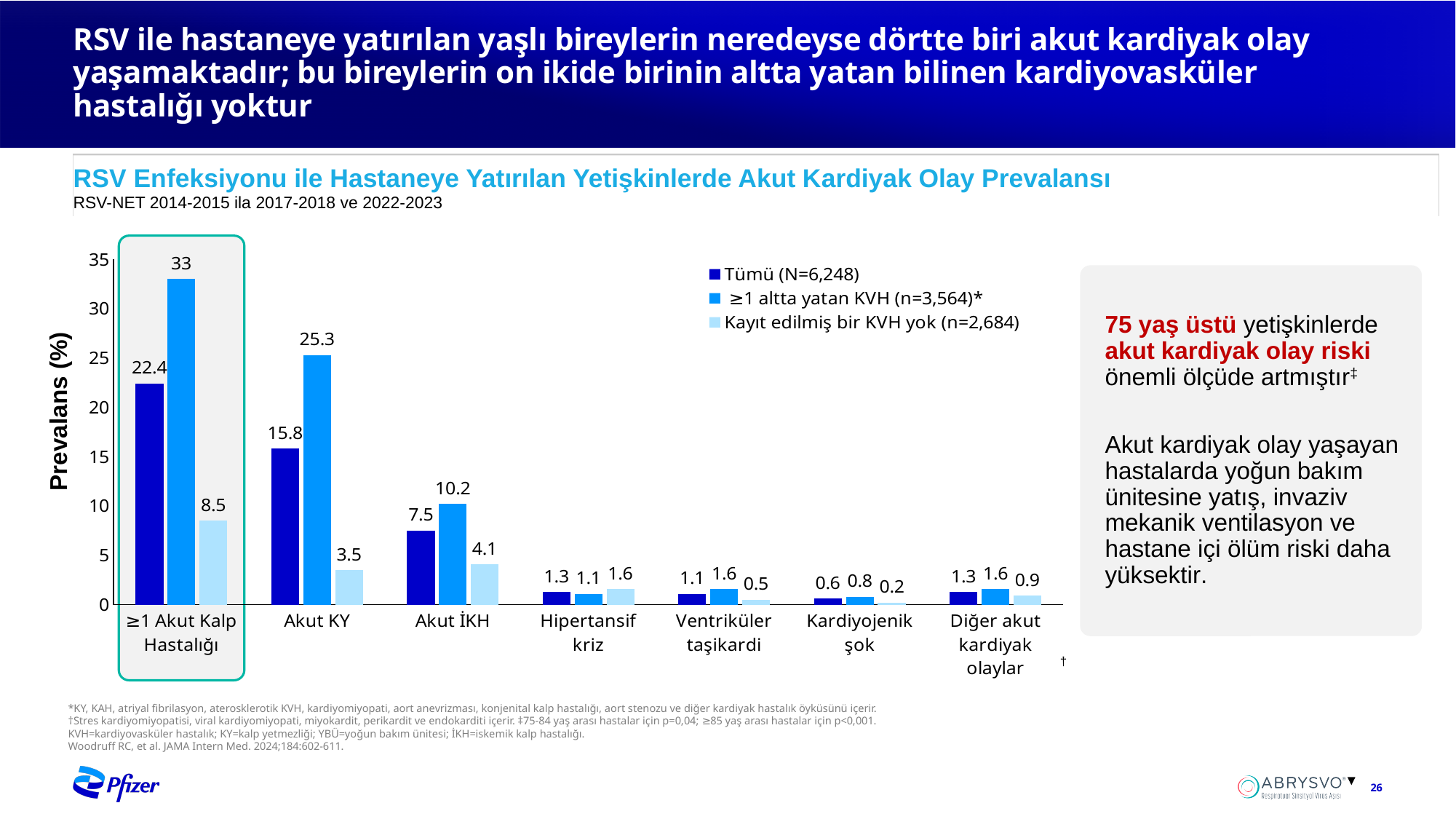
Which category has the highest value in the "≥1 altta yatan KVH (n=3,564)" series? ≥1 Akut Kalp Hastalığı What is the prevalence for "Akut İKH" in the "Kayıt edilmiş bir KVH yok (n=2,684)" series? 4.1 What is the prevalence for "≥1 Akut Kalp Hastalığı" in the "Tümü (N=6,248)" series? 22.4 For "Akut KY", which is larger: the "Tümü" value or the "Kayıt edilmiş bir KVH yok" value? Tümü Is the "Tümü" value for "Akut KY" greater or less than 20? less How many series does the chart legend list? 3 What is the prevalence for "Akut KY" in the "≥1 altta yatan KVH (n=3,564)" series? 25.3 Which category has the lowest value in the "Kayıt edilmiş bir KVH yok (n=2,684)" series? Kardiyojenik şok What kind of chart is shown on the slide? bar chart What is the label of the y axis of the chart? Prevalans (%) What is the difference between the "≥1 altta yatan KVH" and "Kayıt edilmiş bir KVH yok" values for "≥1 Akut Kalp Hastalığı"? 24.5 How many categories are shown on the x axis of the chart? 7